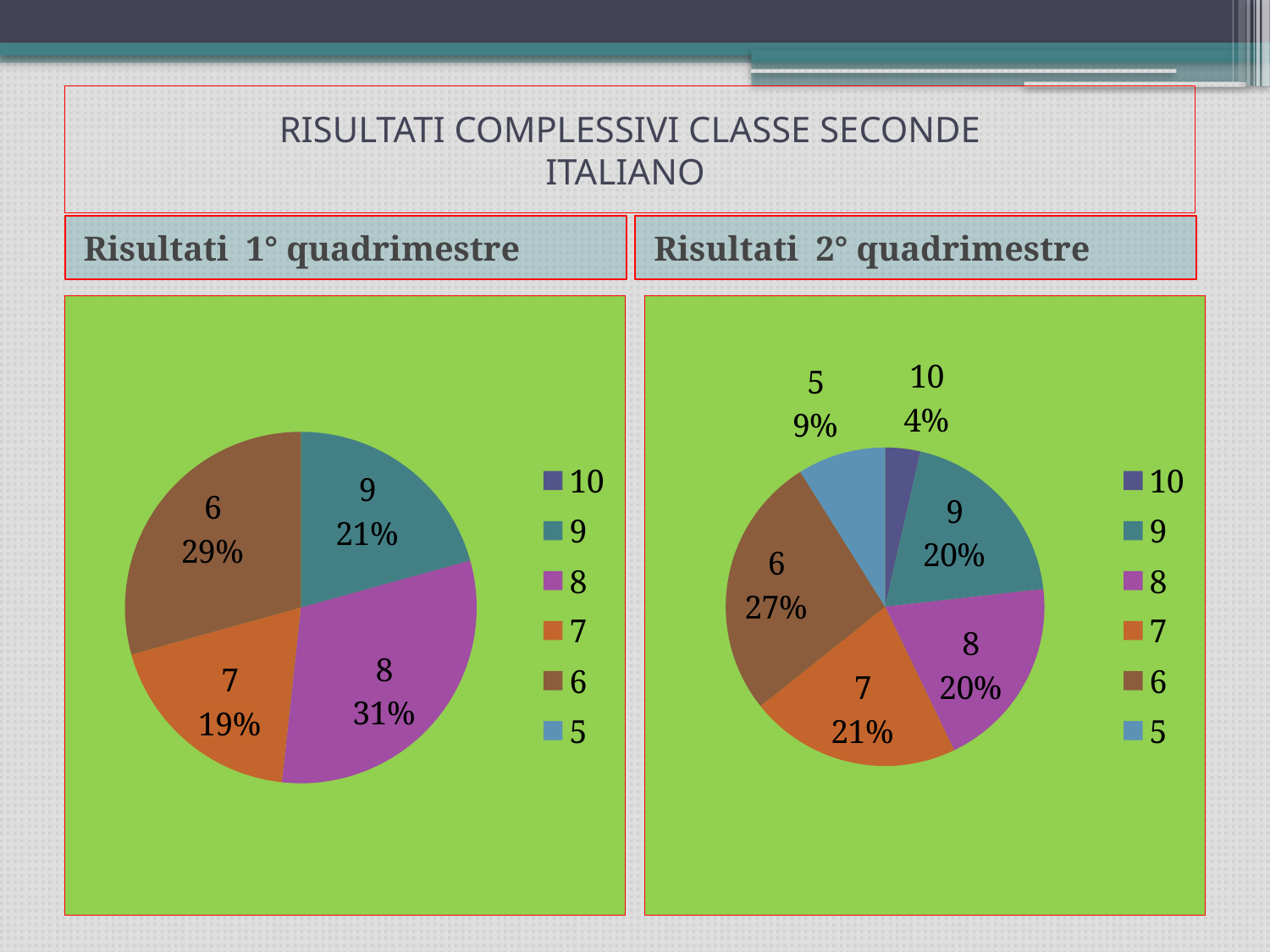
In the 'Risultati 1° quadrimestre' chart, which grade has the largest slice? 8 In the 'Risultati 1° quadrimestre' chart, which grade has the smallest slice among those shown in the pie? 7 How many entries does the legend of the 'Risultati 2° quadrimestre' chart list? 6 In the 'Risultati 1° quadrimestre' chart, what is the difference in percentage points between grade 8 and grade 9? 10 In the 'Risultati 1° quadrimestre' chart, what share of the pie does grade 8 have? 31% In the 'Risultati 2° quadrimestre' chart, which grade has the smallest slice? 10 What kind of chart is used for 'Risultati 1° quadrimestre'? Pie chart In the 'Risultati 2° quadrimestre' chart, what share of the pie does grade 10 have? 4% In the 'Risultati 1° quadrimestre' chart, what share of the pie does grade 6 have? 29% In the 'Risultati 2° quadrimestre' chart, which grade has the largest slice? 6 In the 'Risultati 2° quadrimestre' chart, how many slices does the pie have? 6 In the 'Risultati 2° quadrimestre' chart, what share of the pie does grade 6 have? 27%